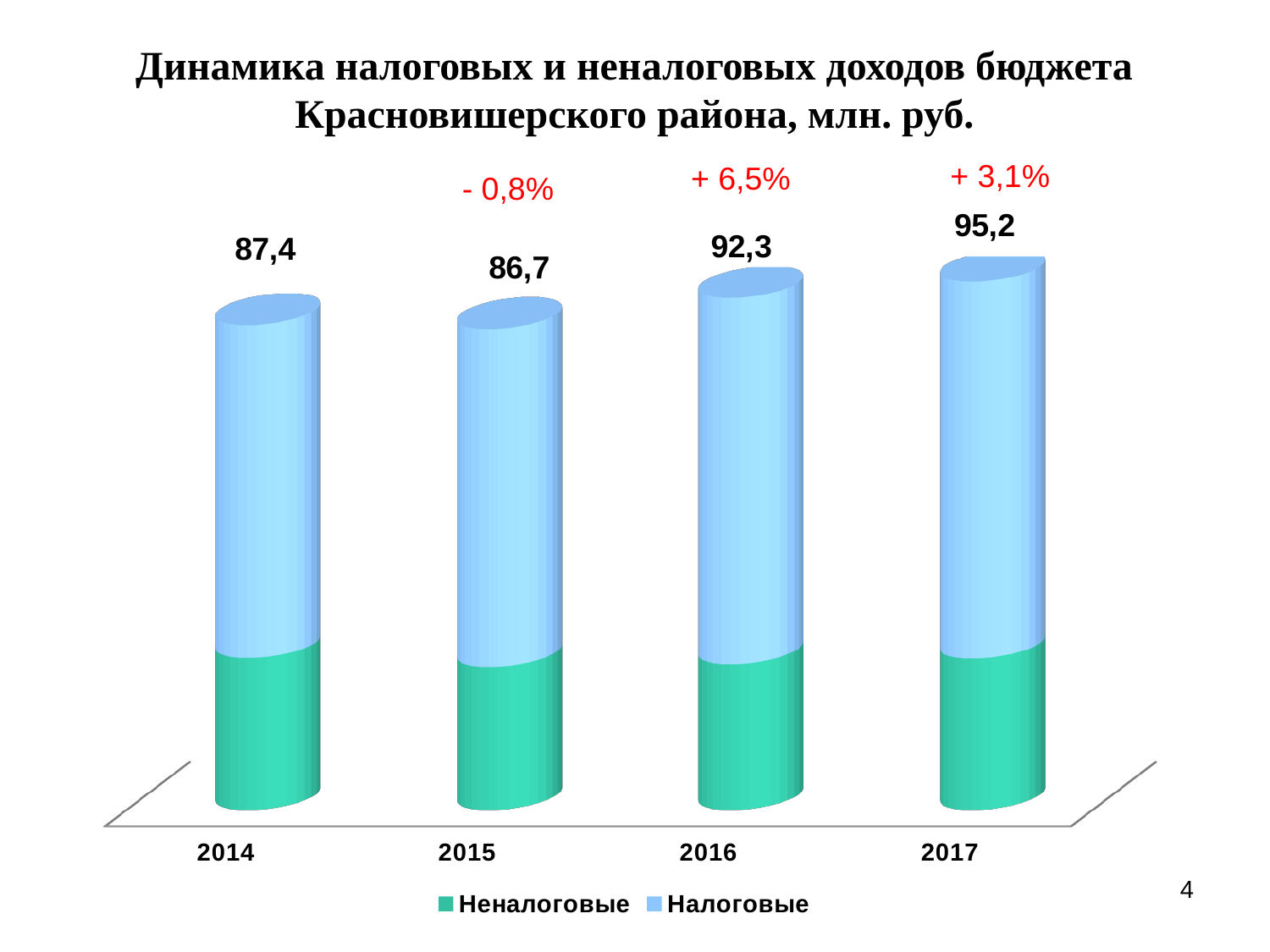
What is the total value labelled for 2017? 95,2 What kind of chart is shown on the slide? Stacked bar chart What is the difference between the 2016 total and the 2015 total? 5,6 Which is larger, the total for 2014 or the total for 2015? 2014 By how much does the 2017 total exceed the 2014 total? 7,8 How many series does the legend list? 2 What percentage change is shown in red above the 2016 bar? + 6,5% What is the total budget revenue shown for 2014? 87,4 Which year has the highest total revenue? 2017 Which year has the lowest total revenue? 2015 How many years are shown on the x axis? 4 What is the total value labelled above the bar for 2016? 92,3